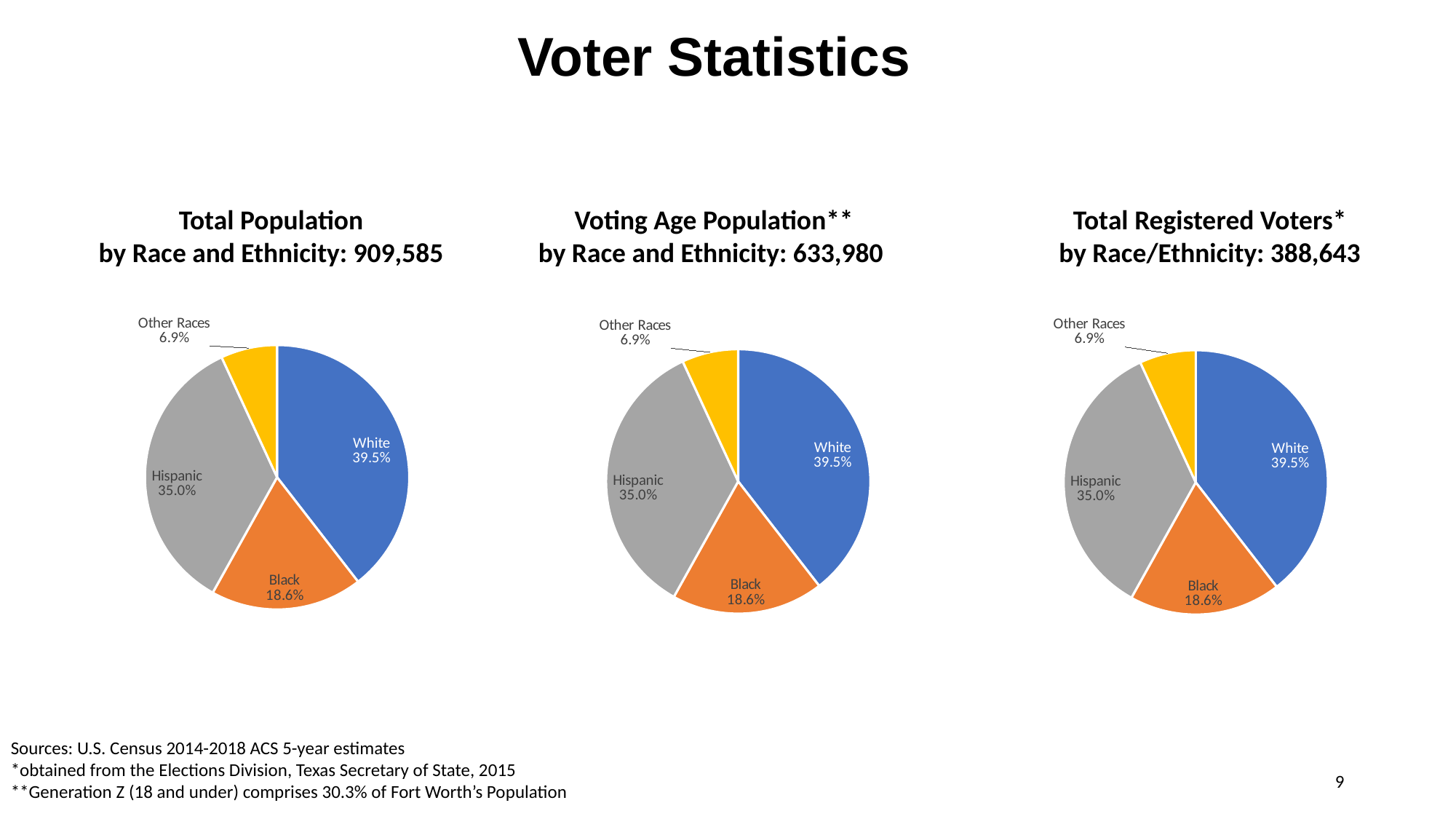
In the Voting Age Population by Race and Ethnicity chart, what share of the pie is Hispanic? 35.0% What type of chart is used for Total Population by Race and Ethnicity? Pie chart In the Voting Age Population by Race and Ethnicity chart, what colour is the Hispanic slice? Gray In the Total Population by Race and Ethnicity chart, what share of the pie is White? 39.5% In the Total Registered Voters by Race/Ethnicity chart, which is larger, the Black slice or the Other Races slice? Black In the Total Registered Voters by Race/Ethnicity chart, which category has the largest slice? White In the Total Population by Race and Ethnicity chart, what share of the pie is Other Races? 6.9% In the Voting Age Population by Race and Ethnicity chart, which category has the smallest slice? Other Races What total is given in the title of the Total Registered Voters by Race/Ethnicity chart? 388,643 How many slices does the Voting Age Population by Race and Ethnicity pie chart have? 4 In the Total Population by Race and Ethnicity chart, what is the difference in percentage points between the White and Hispanic slices? 4.5